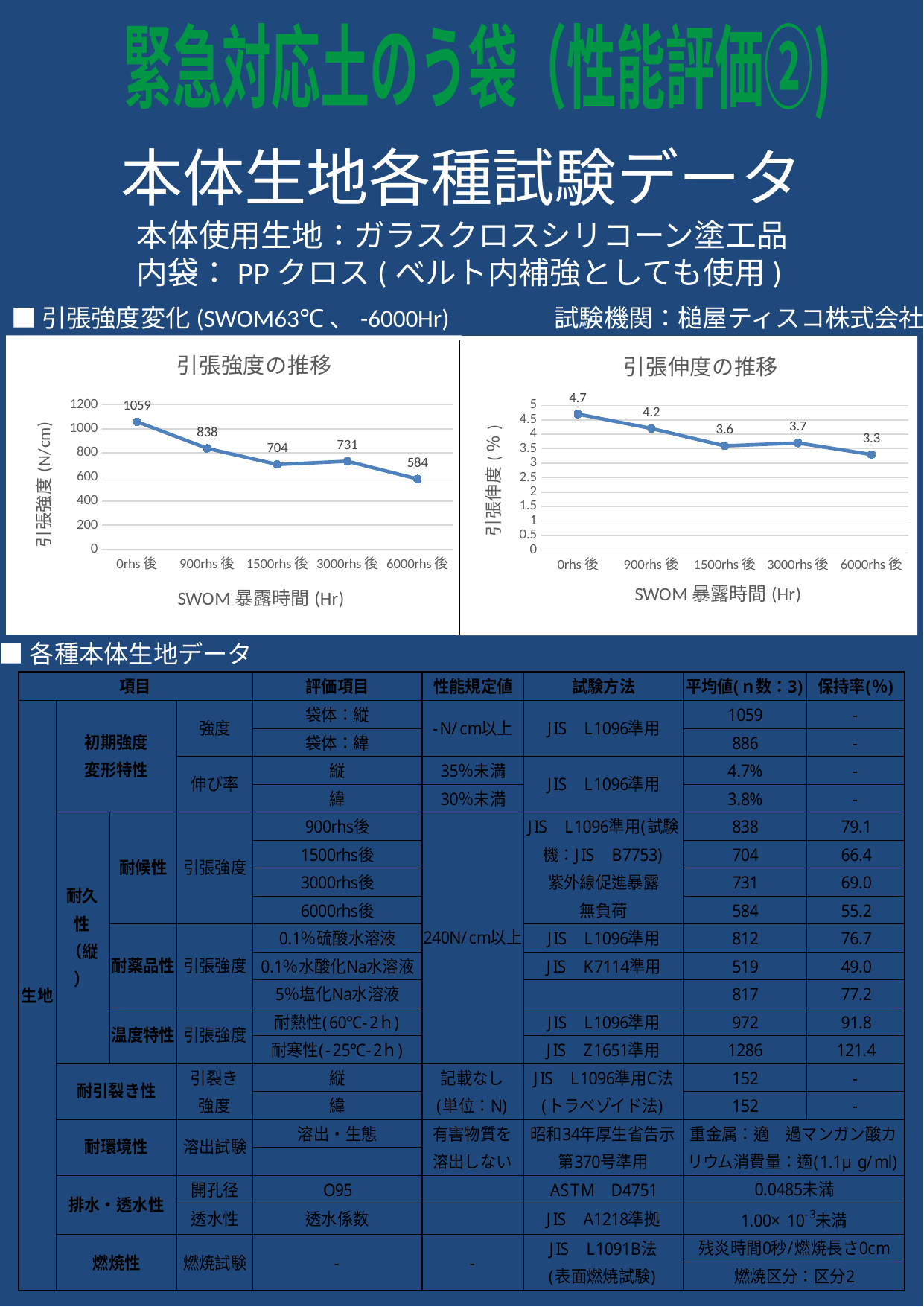
In the 引張強度の推移 chart, which exposure time has the lowest value? 6000rhs後 In the 引張強度の推移 chart, what is the value at 3000rhs後? 731 What kind of chart is the 引張強度の推移 chart? line chart In the 引張強度の推移 chart, which is larger, the value at 1500rhs後 or at 3000rhs後? 3000rhs後 In the 引張伸度の推移 chart, which exposure time has the highest value? 0rhs後 In the 引張強度の推移 chart, what is the value at 0rhs後? 1059 In the 引張強度の推移 chart, what is the difference between the values at 0rhs後 and 6000rhs後? 475 What is the x-axis title of the 引張伸度の推移 chart? SWOM暴露時間(Hr) In the 引張伸度の推移 chart, what is the value at 900rhs後? 4.2 In the 引張伸度の推移 chart, what is the difference between the values at 0rhs後 and 1500rhs後? 1.1 In the 引張強度の推移 chart, how many data points are plotted? 5 In the 引張伸度の推移 chart, what is the value at 6000rhs後? 3.3